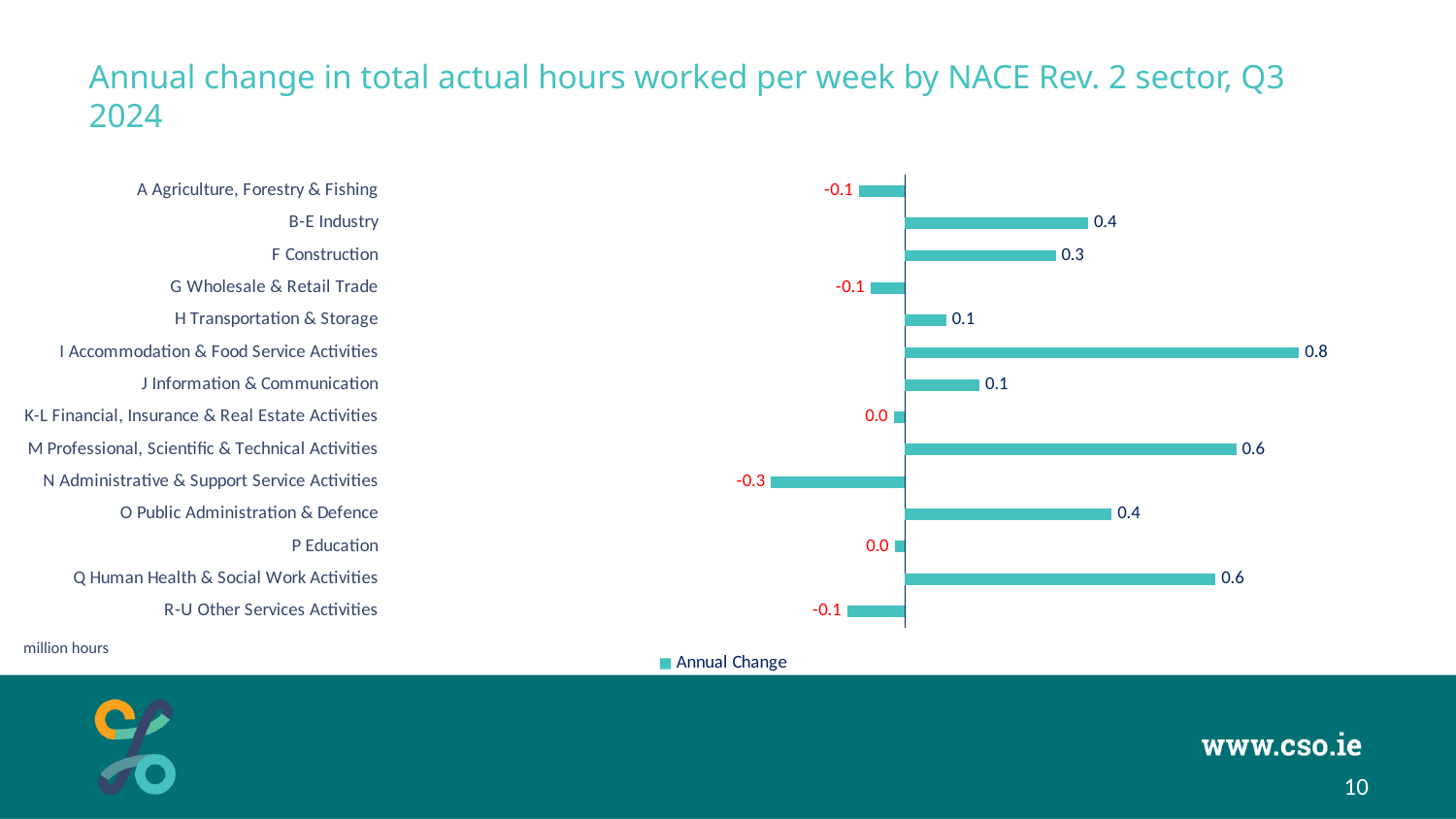
What unit is stated for the values in the chart? million hours How many series does the legend list? 1 What is the annual change for N Administrative & Support Service Activities? -0.3 What is the difference between the annual change for B-E Industry and H Transportation & Storage? 0.3 Which sector has the lowest annual change in total actual hours worked? N Administrative & Support Service Activities Which sector has the highest annual change in total actual hours worked? I Accommodation & Food Service Activities What is the annual change for F Construction? 0.3 Which has a larger annual change, M Professional, Scientific & Technical Activities or O Public Administration & Defence? M Professional, Scientific & Technical Activities What kind of chart is shown on the slide? Bar chart How many sectors are shown in the chart? 14 What is the annual change in total actual hours worked for I Accommodation & Food Service Activities? 0.8 What is the annual change for P Education? 0.0